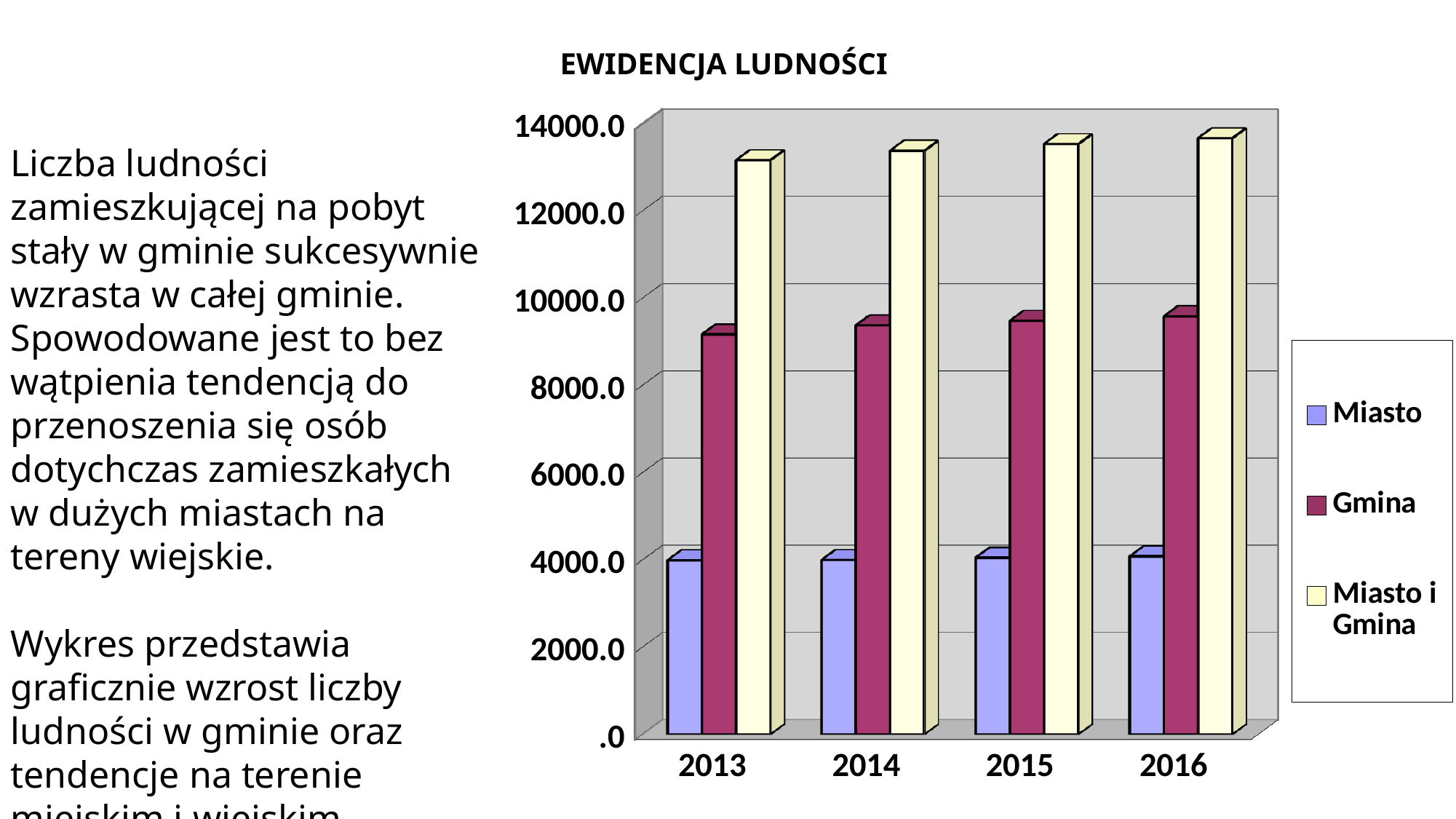
What is the title of the chart? EWIDENCJA LUDNOŚCI Do the values for Miasto i Gmina rise or fall from 2013 to 2016? rise Is the value for Miasto i Gmina in 2013 greater or less than 12000? greater Which series has the lowest bar in 2013? Miasto How many years are shown on the x axis of the chart? 4 Is the value for Gmina in 2016 greater or less than 10000? less Which series has the highest bar in 2016? Miasto i Gmina Which is larger: the Gmina value in 2013 or the Gmina value in 2016? 2016 Is the value for Miasto i Gmina in 2016 greater or less than 14000? less What kind of chart is shown on the slide? bar chart How many series does the legend list? 3